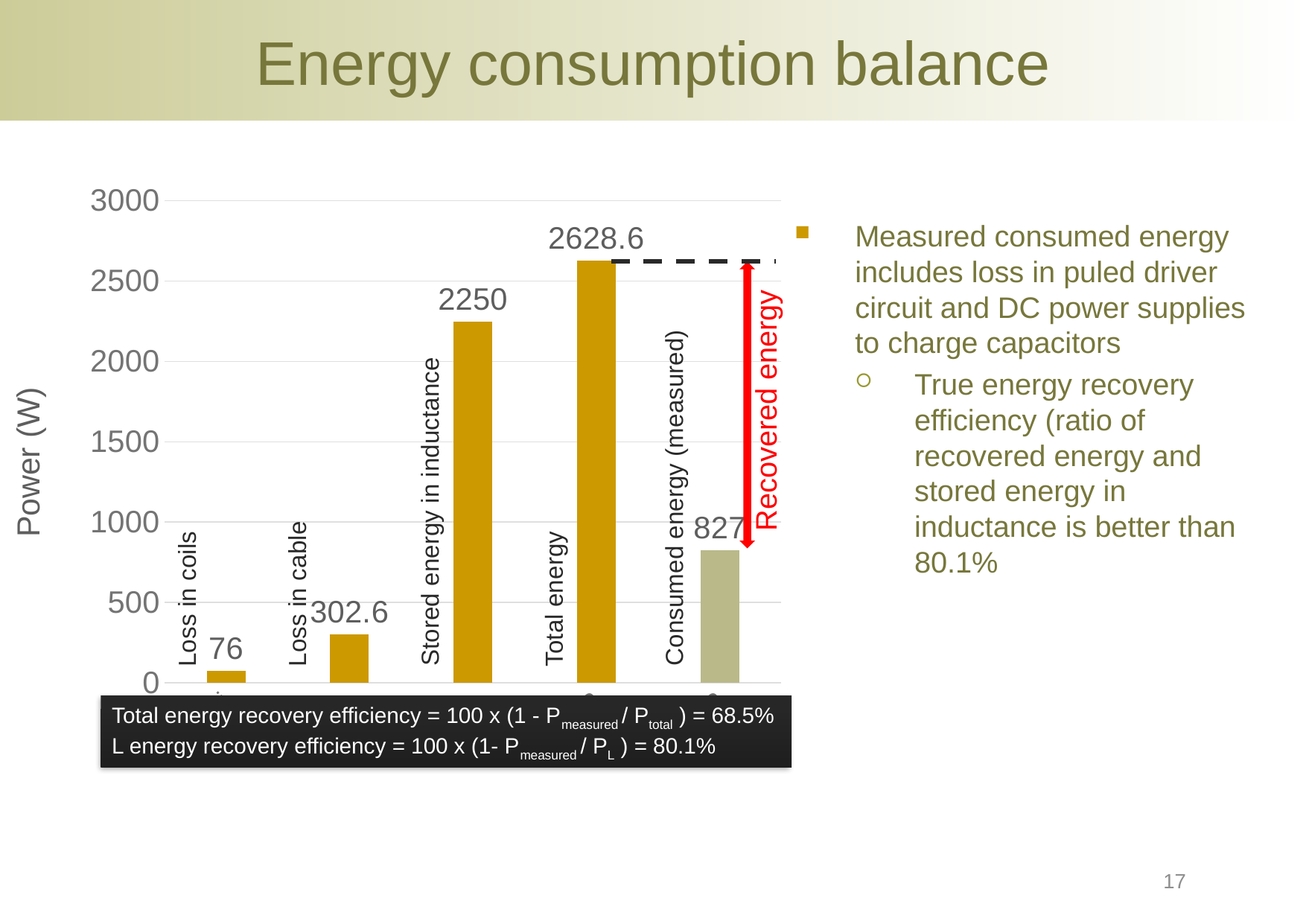
Which is larger, Loss in cable or Consumed energy (measured)? Consumed energy (measured) What is the value for Total energy? 2628.6 Which category has the highest value? Total energy How many categories are shown in the chart? 5 What is the value for Loss in cable? 302.6 Which category has the lowest value? Loss in coils What kind of chart is shown on the slide? Bar chart What is the difference between Total energy and Consumed energy (measured)? 1801.6 What is the value for Consumed energy (measured)? 827 What is the value for Stored energy in inductance? 2250 What is the value for Loss in coils? 76 What is the label of the vertical axis? Power (W)